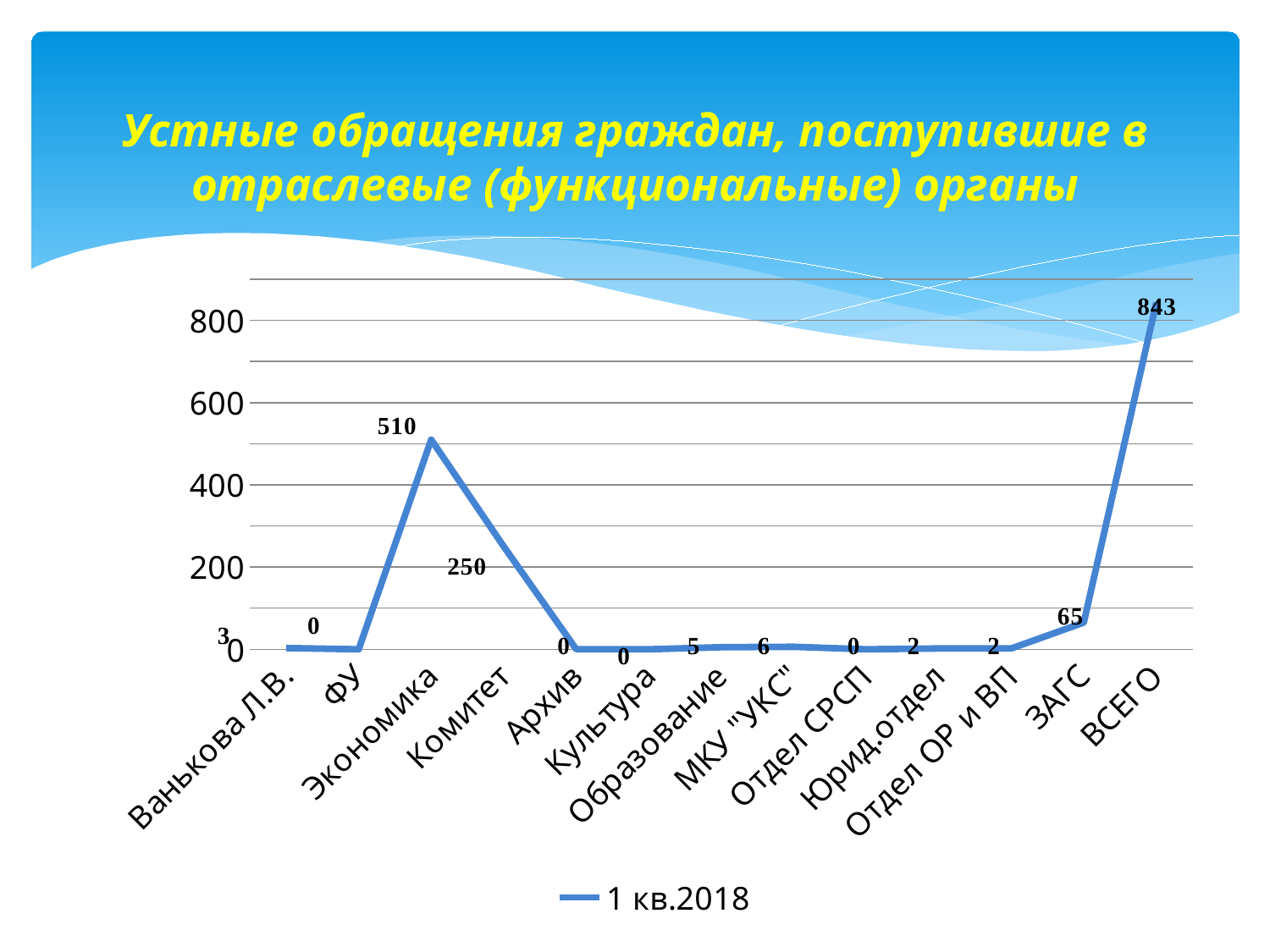
Which category has the highest value? ВСЕГО Which is larger, the value for Образование or the value for МКУ "УКС"? МКУ "УКС" What is the difference between the values for Экономика and Комитет? 260 What is the value for ВСЕГО? 843 How many series does the legend list? 1 What kind of chart is shown on the slide? line chart Is the value for Экономика greater or less than 400? greater How many categories are shown on the x axis? 13 What is the difference between the values for ВСЕГО and Экономика? 333 What is the value for ЗАГС? 65 What is the value for Экономика? 510 What is the value for Комитет? 250